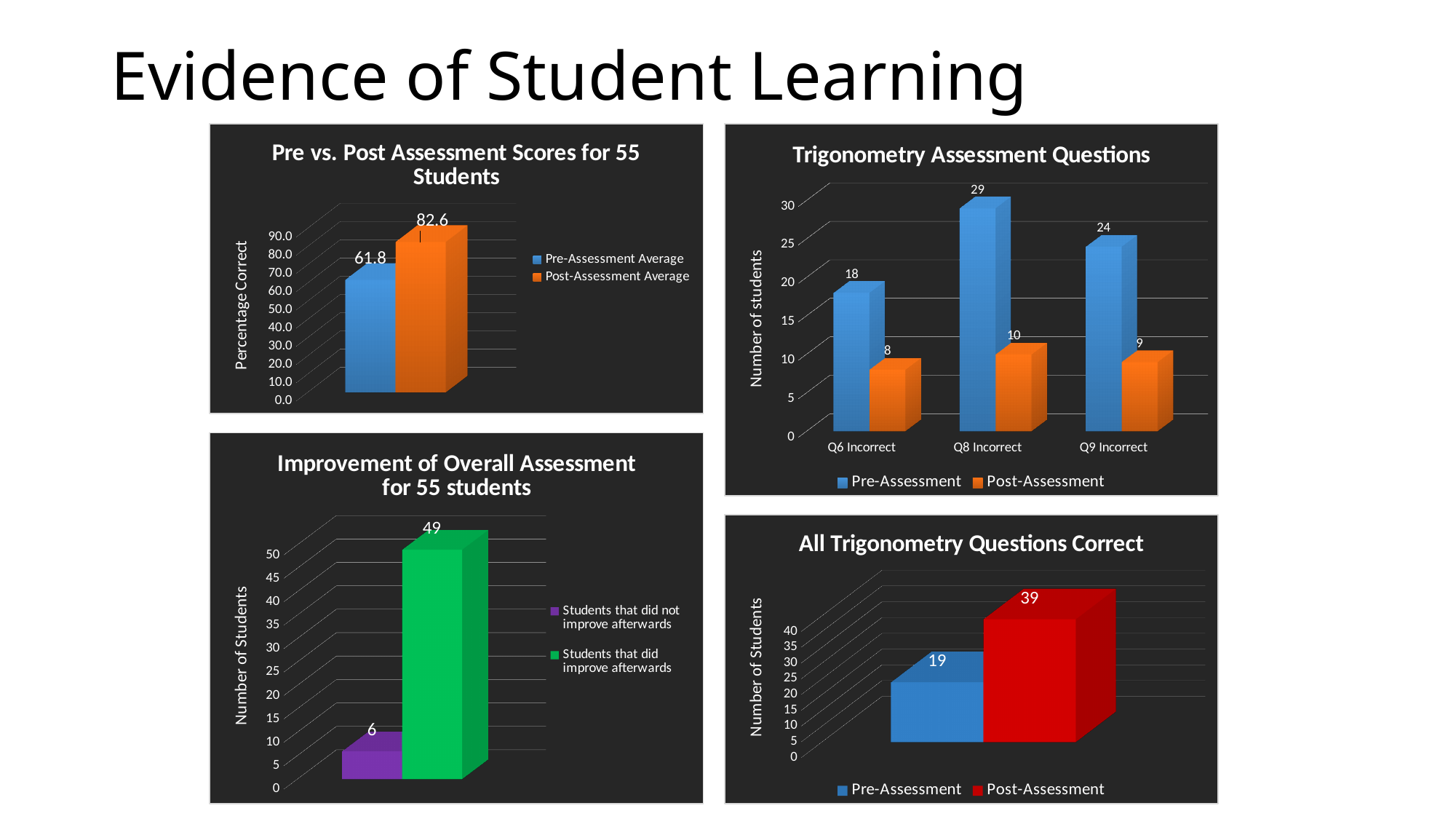
In the 'Improvement of Overall Assessment for 55 students' chart, which is larger: students that did improve or students that did not improve? Students that did improve afterwards In the 'Improvement of Overall Assessment for 55 students' chart, how many students did not improve afterwards? 6 In the 'Pre vs. Post Assessment Scores for 55 Students' chart, what is the difference between the Post-Assessment Average and the Pre-Assessment Average? 20.8 In the 'Pre vs. Post Assessment Scores for 55 Students' chart, what is the Pre-Assessment Average? 61.8 In the 'Trigonometry Assessment Questions' chart, what is the difference between Pre-Assessment and Post-Assessment for Q9 Incorrect? 15 In the 'Trigonometry Assessment Questions' chart, how many students got Q8 incorrect on the Pre-Assessment? 29 In the 'All Trigonometry Questions Correct' chart, what is the difference between Post-Assessment and Pre-Assessment? 20 In the 'All Trigonometry Questions Correct' chart, what is the Post-Assessment value? 39 In the 'Trigonometry Assessment Questions' chart, how many categories are shown on the x axis? 3 In the 'Pre vs. Post Assessment Scores for 55 Students' chart, what is the Post-Assessment Average? 82.6 What type of chart is the 'All Trigonometry Questions Correct' chart? Bar chart In the 'Trigonometry Assessment Questions' chart, which question had the fewest students incorrect on the Post-Assessment? Q6 Incorrect